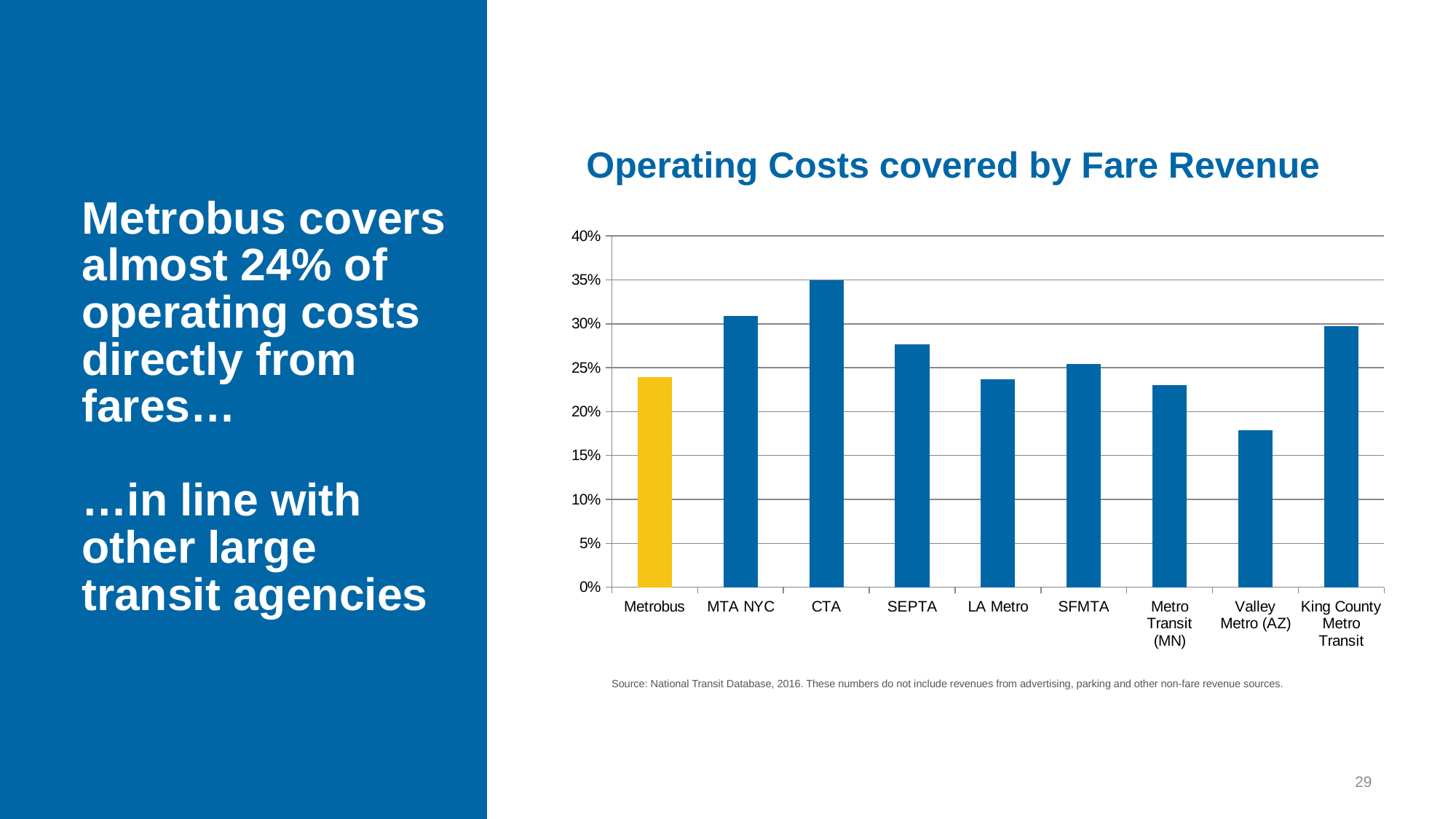
Which agency has the highest share of operating costs covered by fare revenue? CTA Which bar in the chart is coloured differently (yellow) from the others? Metrobus Is the value for Metro Transit (MN) greater or less than 25%? less Which is larger, the value for MTA NYC or the value for SEPTA? MTA NYC How many transit agencies are shown on the x axis of the chart? 9 Which is larger, the value for Metrobus or the value for Valley Metro (AZ)? Metrobus Is the value for MTA NYC greater or less than 30%? greater Which agency has the lowest share of operating costs covered by fare revenue? Valley Metro (AZ) Is the value for Valley Metro (AZ) greater or less than 20%? less What is the title of the chart? Operating Costs covered by Fare Revenue What type of chart is shown on the slide? Bar chart